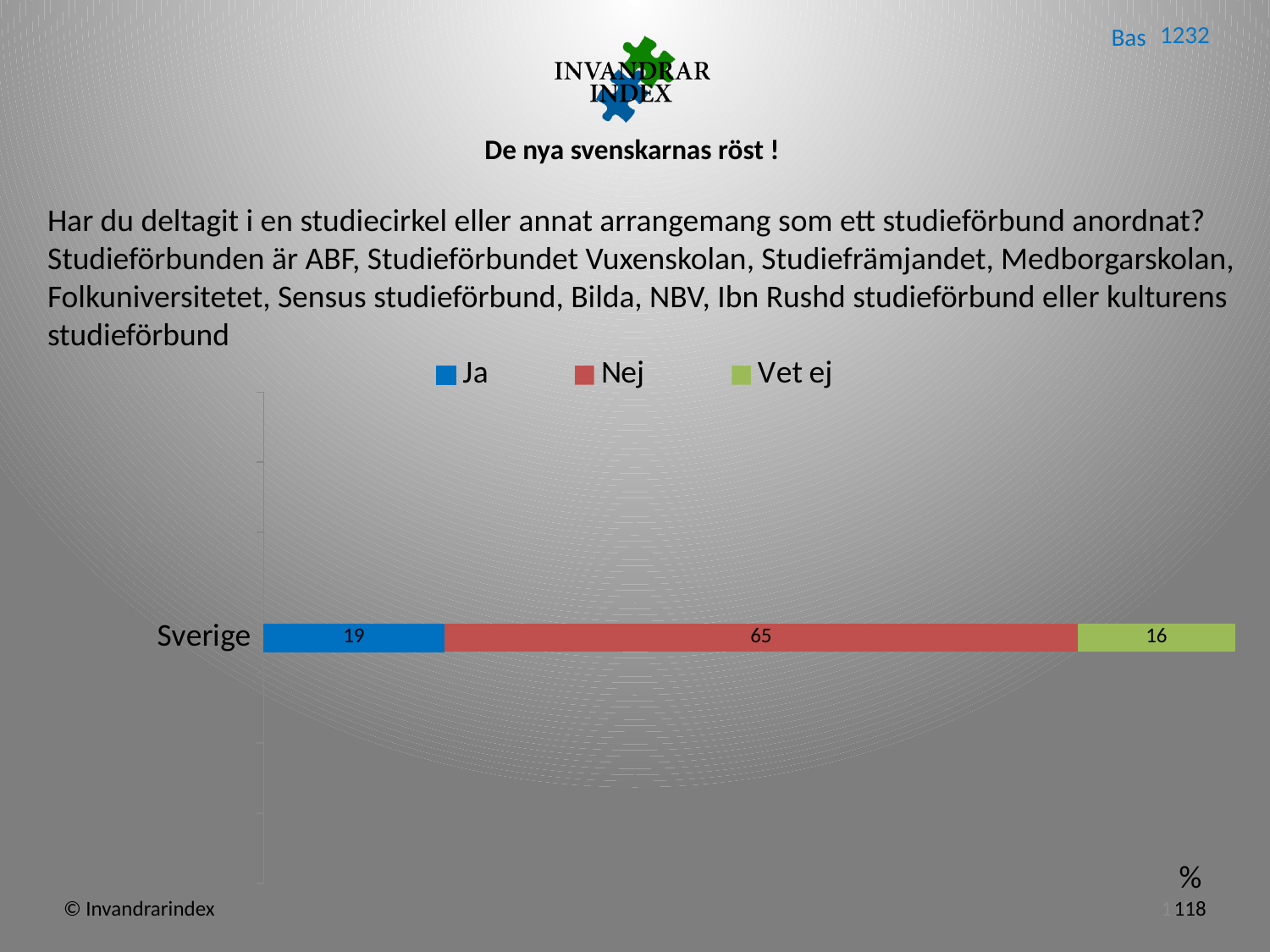
What is the value for Vet ej for Sverige? 16 How many categories are shown on the chart? 1 How many series does the legend list? 3 What is the value for Nej for Sverige? 65 What is the total of the stacked bar for Sverige? 100 What kind of chart is shown on the slide? Stacked bar chart Which series has the lowest value for Sverige? Vet ej What is the value for Ja for Sverige? 19 Which series has the highest value for Sverige? Nej Which is larger for Sverige, Ja or Vet ej? Ja What is the difference between the Nej and Ja values for Sverige? 46 Which colour represents Nej in the legend? Red